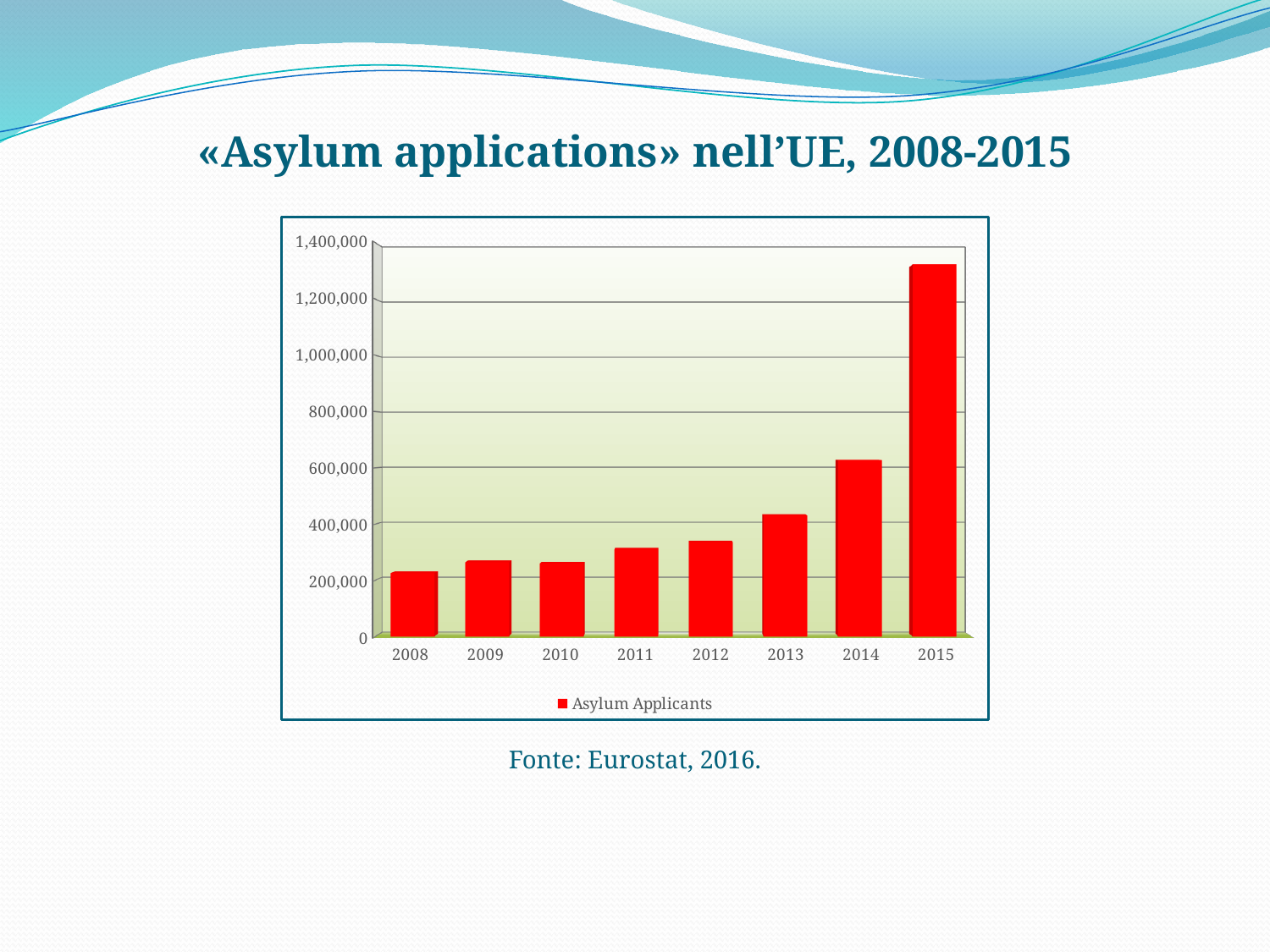
Is the value for 2014 greater or less than 800,000? less How many series does the chart's legend list? 1 Which year has the lowest number of asylum applicants? 2008 How many years are shown on the x axis of the chart? 8 Is the value for 2015 greater or less than 1,200,000? greater What is the series name shown in the chart's legend? Asylum Applicants Is the value for 2008 greater or less than 400,000? less Which year has the larger value, 2013 or 2014? 2014 Which year has the highest number of asylum applicants? 2015 Do the values generally rise or fall from 2008 to 2015? rise What kind of chart is shown on the slide? bar chart